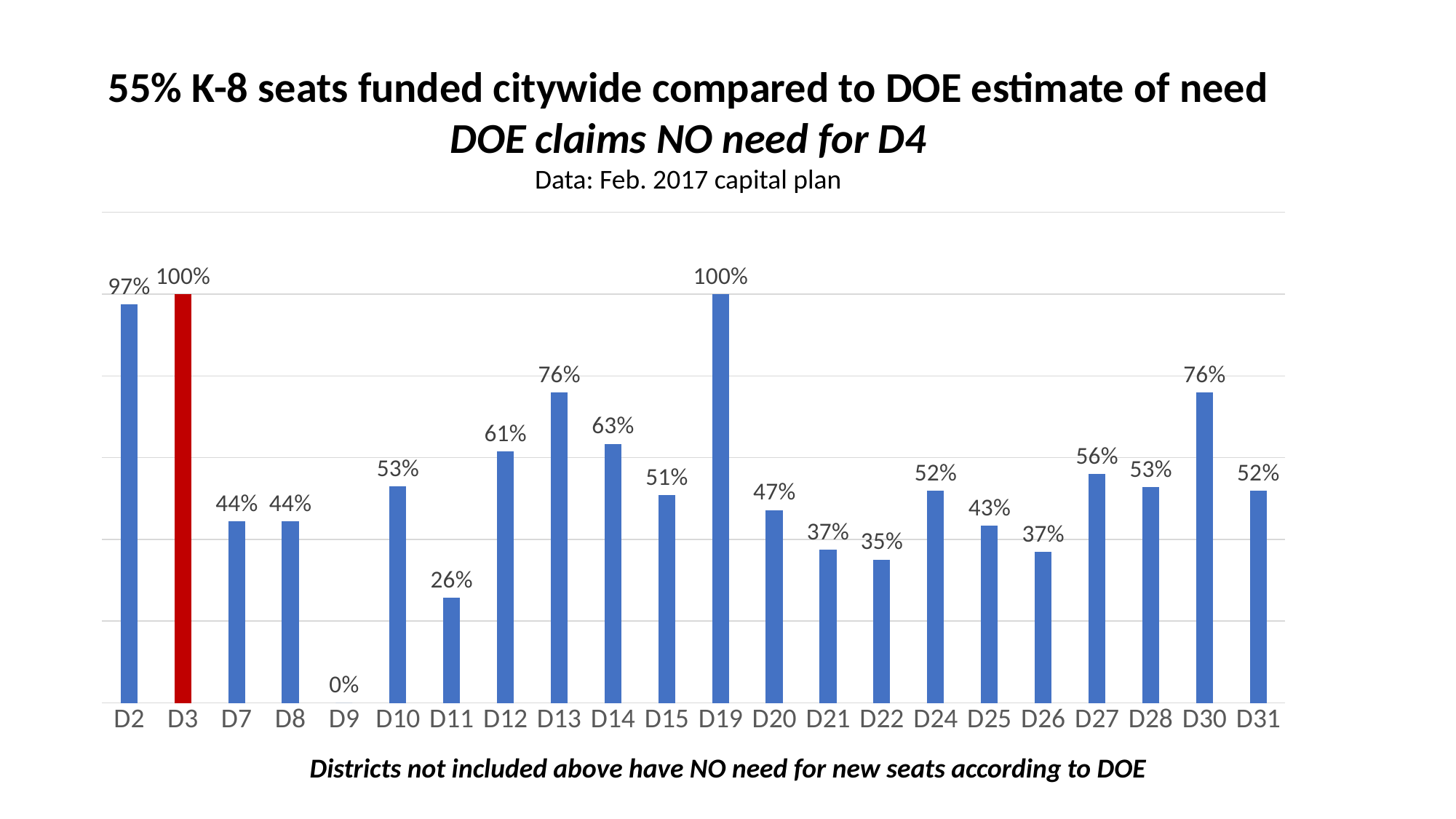
How many districts are shown on the x axis? 22 Which bar is coloured red instead of blue? D3 Which is larger, the value for D14 or the value for D15? D14 What kind of chart is shown on the slide? Bar chart Which two districts share the highest value of 100%? D3 and D19 What is the value for D11? 26% What is the value for D22? 35% Which district has the lowest value? D9 What is the value for D13? 76% What is the difference between the values for D30 and D31? 24% What data source is cited under the chart title? Feb. 2017 capital plan What is the difference between the values for D2 and D20? 50%